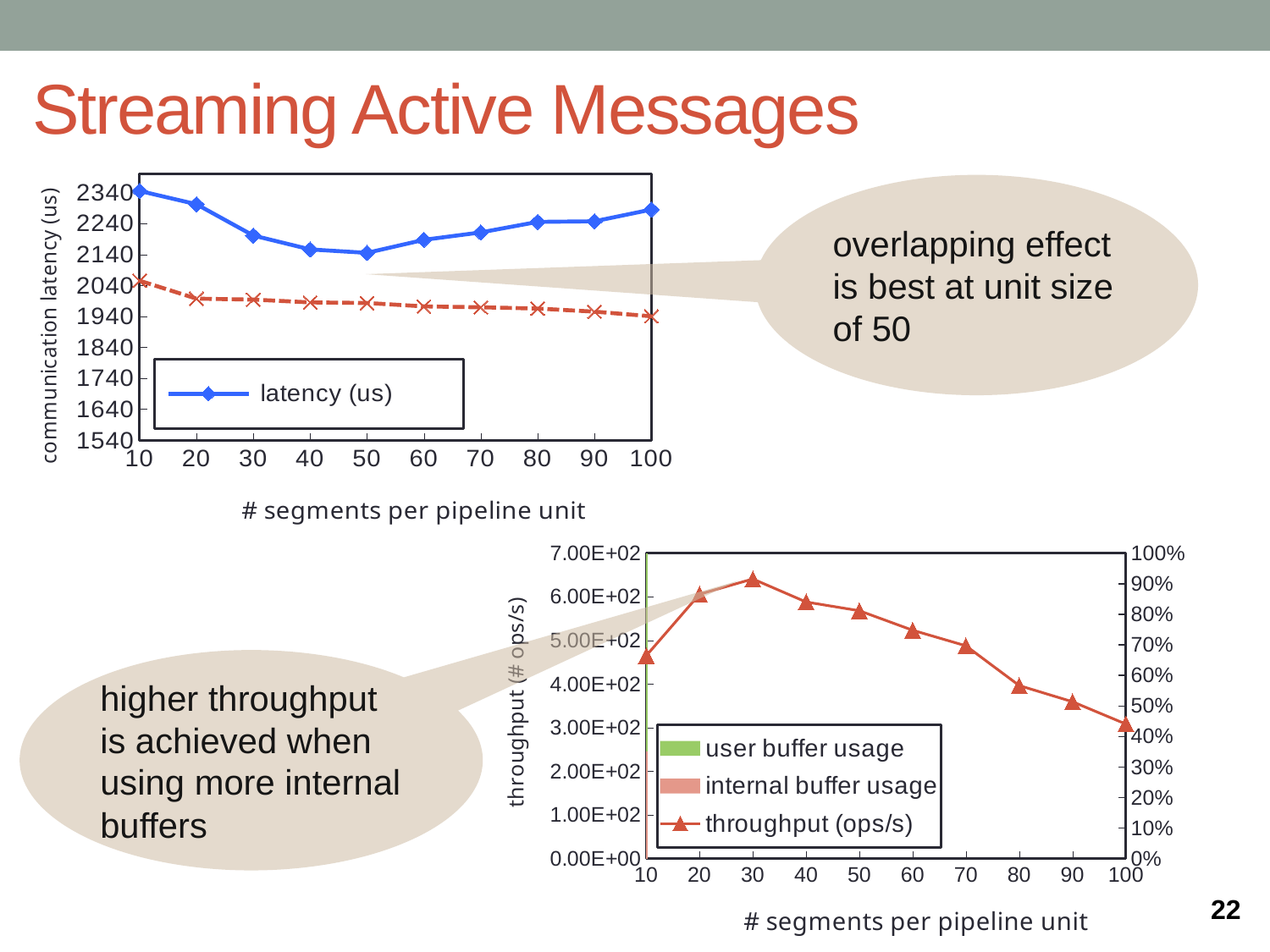
How many series does the legend of the bottom throughput chart list? 3 In the bottom chart, is the throughput (ops/s) at 30 segments per pipeline unit greater or less than 6.00E+02? greater In the top chart, at which number of segments per pipeline unit is the latency (us) highest? 10 How many data points does the latency (us) series in the top chart have? 10 In the bottom chart, does throughput (ops/s) rise or fall from 30 to 100 segments per pipeline unit? fall In the top chart, which has the higher latency (us): 10 or 100 segments per pipeline unit? 10 In the top chart, is the latency (us) at 10 segments per pipeline unit greater or less than 2240? greater What kind of chart is the top chart showing communication latency? line chart In the bottom chart, at which number of segments per pipeline unit is throughput (ops/s) lowest? 100 In the top chart, at which number of segments per pipeline unit is the latency (us) lowest? 50 In the bottom chart, at which number of segments per pipeline unit is throughput (ops/s) highest? 30 In the top chart, is the latency (us) at 50 segments per pipeline unit greater or less than 2240? less